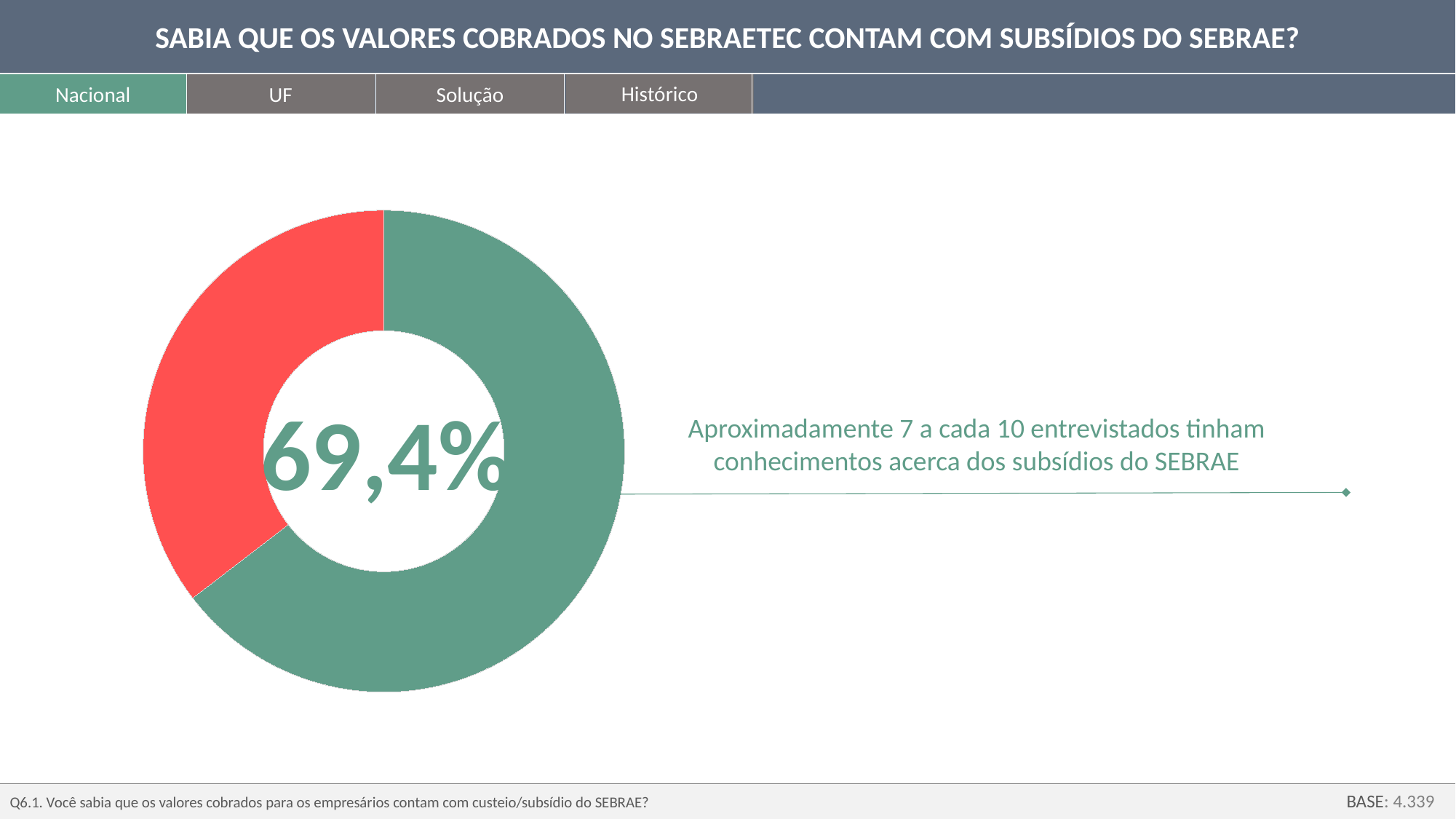
Which slice of the donut chart is the largest? The green slice What is the base (number of respondents) shown at the bottom right of the slide? 4.339 How many slices does the donut chart have? 2 What is the title of the slide containing the donut chart? SABIA QUE OS VALORES COBRADOS NO SEBRAETEC CONTAM COM SUBSÍDIOS DO SEBRAE? What kind of chart is shown on the slide? Donut (pie) chart What percentage is printed in the centre of the donut chart? 69,4% Which slice of the donut chart is larger, the green one or the red one? The green one What share of the donut chart does the green slice represent? 69,4% Which slice of the donut chart is the smallest? The red slice